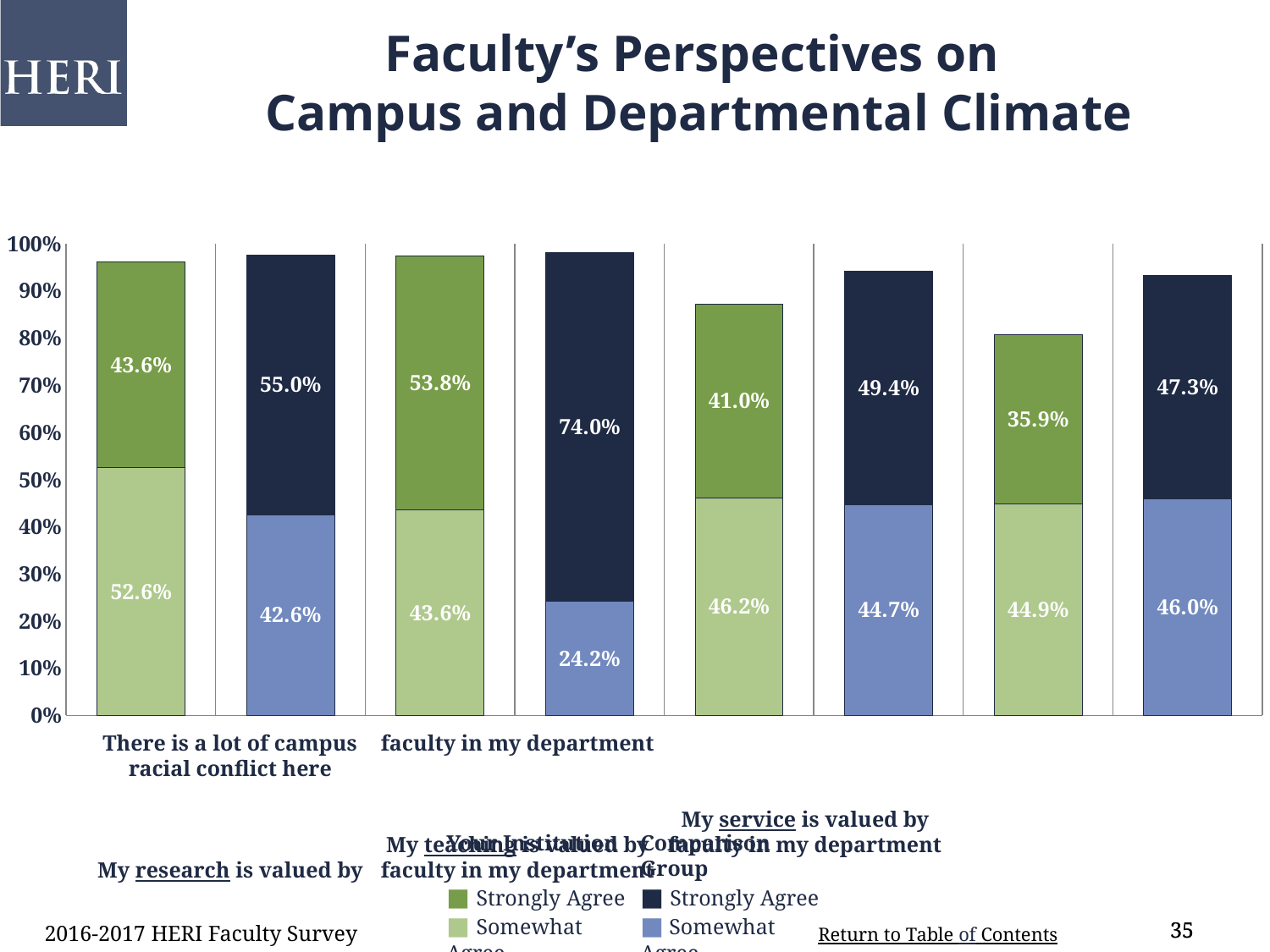
What is the 'Somewhat Agree' value shown in the light blue segment of the fourth bar from the left? 24.2% What is the 'Somewhat Agree' value for the first bar from the left, 'There is a lot of campus racial conflict here'? 52.6% What is the total of the two segments in the first bar from the left, 'There is a lot of campus racial conflict here'? 96.2% Which is larger: the 'Strongly Agree' value of the seventh bar from the left (35.9%) or the 'Strongly Agree' value of the eighth bar from the left (47.3%)? The eighth bar (47.3%) What is the 'Strongly Agree' value shown in the dark navy segment of the fourth bar from the left? 74.0% What is the difference between the 'Strongly Agree' value of the fourth bar (74.0%) and the 'Strongly Agree' value of the second bar (55.0%)? 19.0% What is the 'Strongly Agree' value for the first bar from the left, 'There is a lot of campus racial conflict here'? 43.6% Which bar has the largest 'Strongly Agree' segment? The fourth bar from the left (74.0%) How many entries does the chart legend list? 4 What kind of chart is shown on the slide? Stacked bar chart Which bar has the smallest 'Somewhat Agree' segment? The fourth bar from the left (24.2%) How many bars are plotted in the chart? 8